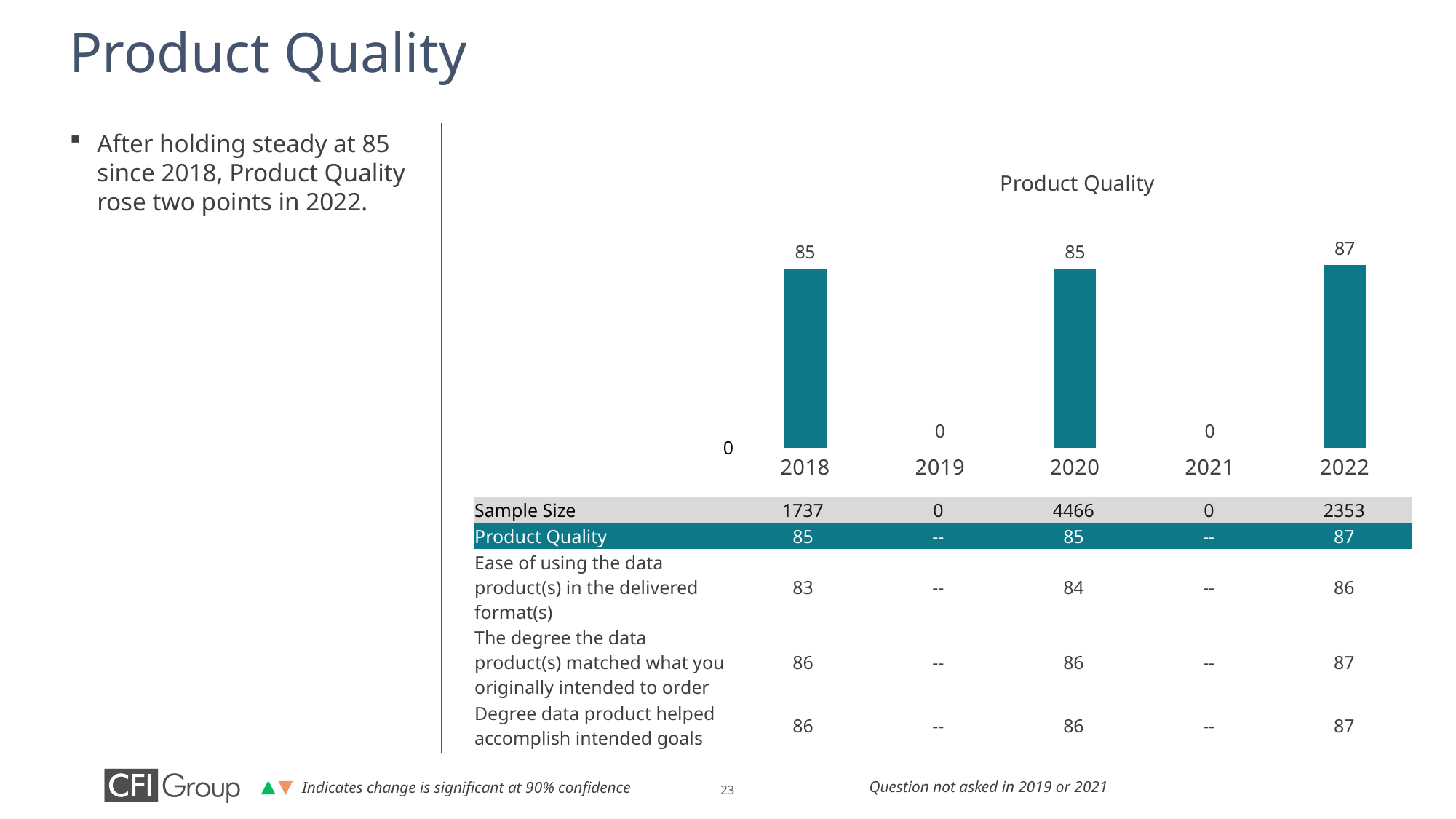
What value is shown for 2019 and 2021 in the chart? 0 What is the title of the chart? Product Quality What is the difference between the Product Quality values for 2022 and 2020? 2 Which year has the highest Product Quality value? 2022 What is the Product Quality value for 2022? 87 How many years are shown on the x axis of the chart? 5 What is the Product Quality value for 2020? 85 Does the Product Quality value rise or fall from 2020 to 2022? Rise How many years in the chart have a non-zero bar? 3 What type of chart is shown on the slide? Bar chart Is the Product Quality value for 2022 larger than the value for 2018? Yes What is the Product Quality value for 2018? 85